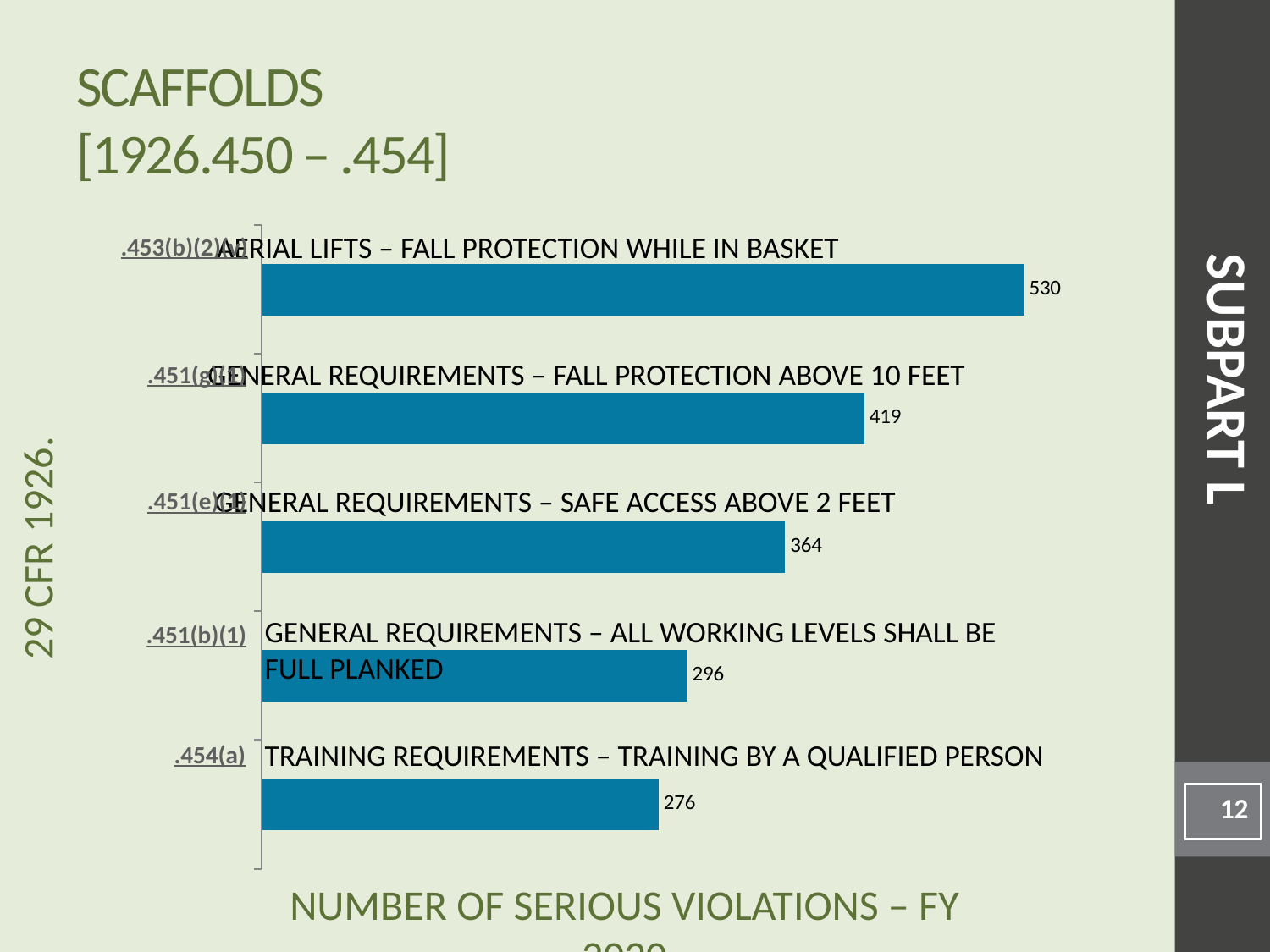
What is the value for .451(b)(1) (General requirements – all working levels shall be full planked)? 296 Which is larger: the value for General requirements – safe access above 2 feet or the value for .451(b)(1)? General requirements – safe access above 2 feet What kind of chart is shown on the slide? Bar chart Which category has the highest number of serious violations? Aerial lifts – fall protection while in basket What is the value for General requirements – safe access above 2 feet? 364 What is the value for .454(a) (Training requirements – training by a qualified person)? 276 Which category has the lowest number of serious violations? .454(a) Training requirements – training by a qualified person What is the difference between the values for Aerial lifts – fall protection while in basket and .454(a)? 254 How many categories (bars) does the chart show? 5 What is the difference between the values for General requirements – fall protection above 10 feet and General requirements – safe access above 2 feet? 55 What is the value for General requirements – fall protection above 10 feet? 419 How many serious violations are shown for Aerial lifts – fall protection while in basket? 530